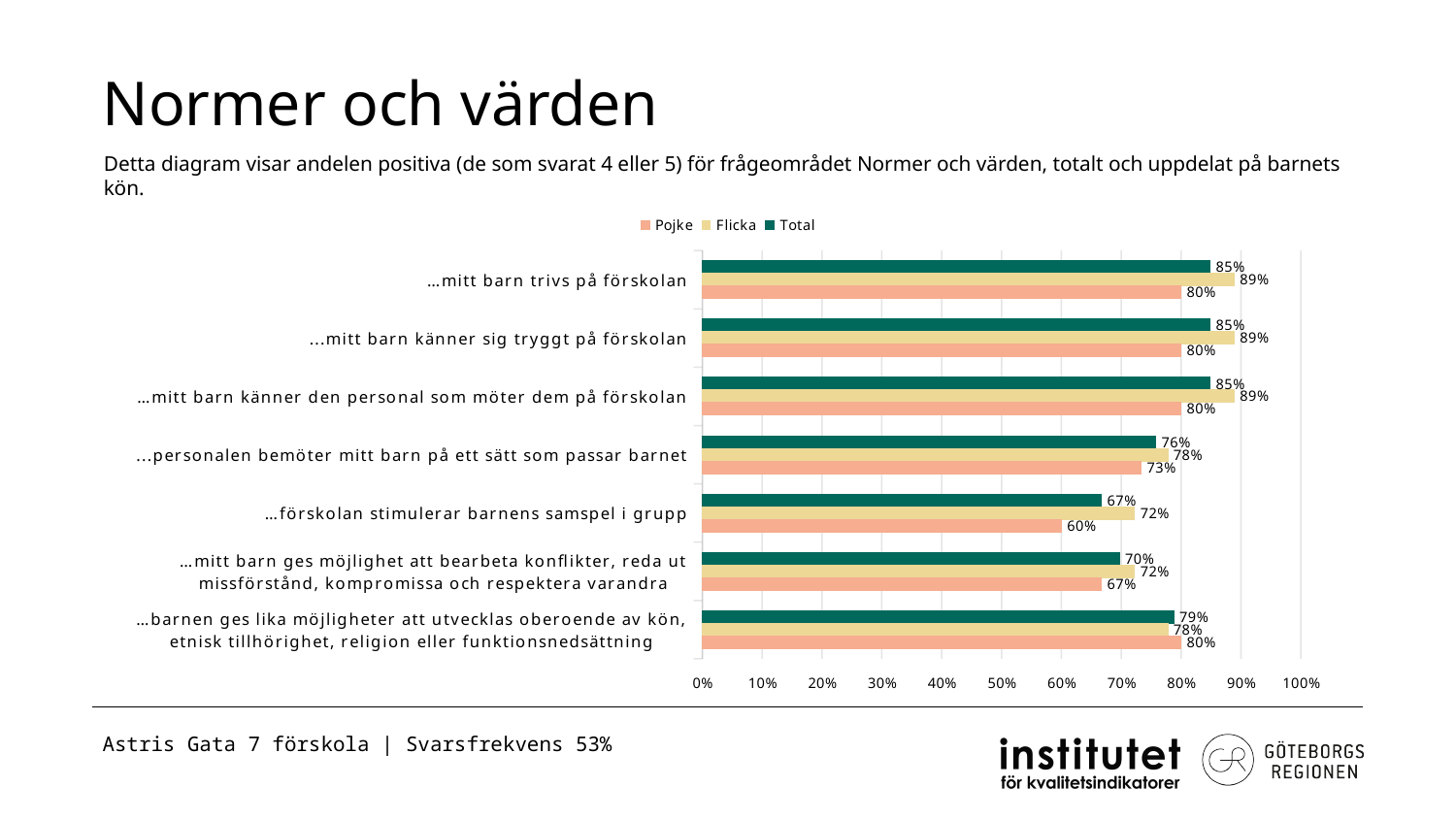
What is the difference between the Flicka and Pojke values for "…mitt barn känner sig tryggt på förskolan"? 9 percentage points What kind of chart is shown on the slide? Bar chart What is the difference between the Flicka and Pojke values for "…förskolan stimulerar barnens samspel i grupp"? 12 percentage points Which category has the lowest Total value? …förskolan stimulerar barnens samspel i grupp How many categories are shown on the chart? 7 How many series does the legend list? 3 Which category has the lowest Pojke value? …förskolan stimulerar barnens samspel i grupp What is the Flicka value for "…mitt barn trivs på förskolan"? 89% What is the Total value for "...personalen bemöter mitt barn på ett sätt som passar barnet"? 76% What is the Pojke value for "…förskolan stimulerar barnens samspel i grupp"? 60% What is the Pojke value for "…barnen ges lika möjligheter att utvecklas oberoende av kön, etnisk tillhörighet, religion eller funktionsnedsättning"? 80% For "…barnen ges lika möjligheter att utvecklas oberoende av kön, etnisk tillhörighet, religion eller funktionsnedsättning", which is larger, the Pojke value or the Flicka value? Pojke